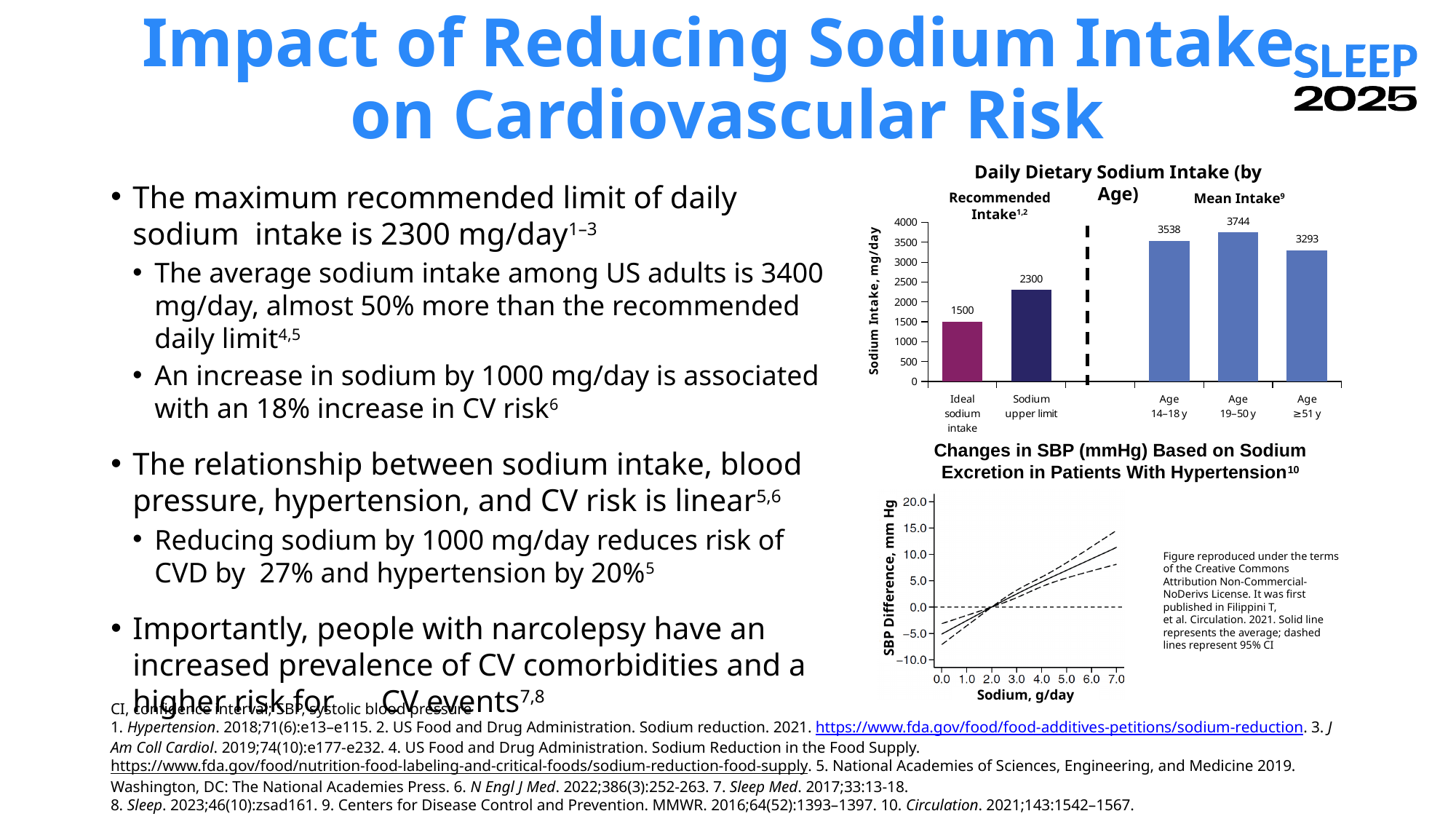
In the Daily Dietary Sodium Intake (by Age) chart, what is the mean intake for Age 19–50 y? 3744 In the Daily Dietary Sodium Intake (by Age) chart, what is the value for Ideal sodium intake? 1500 How many bars are shown in the Daily Dietary Sodium Intake (by Age) chart? 5 In the Daily Dietary Sodium Intake (by Age) chart, which is larger: the mean intake for Age 14–18 y or for Age ≥51 y? Age 14–18 y In the Daily Dietary Sodium Intake (by Age) chart, which category has the highest value? Age 19–50 y What kind of chart is the Daily Dietary Sodium Intake (by Age) chart? Bar chart What is the y-axis label of the Changes in SBP (mmHg) Based on Sodium Excretion chart? SBP Difference, mm Hg In the Daily Dietary Sodium Intake (by Age) chart, what is the mean intake for Age ≥51 y? 3293 In the Daily Dietary Sodium Intake (by Age) chart, what is the difference between the mean intake for Age 14–18 y and the Sodium upper limit? 1238 In the Daily Dietary Sodium Intake (by Age) chart, what is the value for Sodium upper limit? 2300 In the Daily Dietary Sodium Intake (by Age) chart, which category has the lowest value? Ideal sodium intake In the Changes in SBP chart, does the solid average line rise or fall as sodium (g/day) increases? Rises